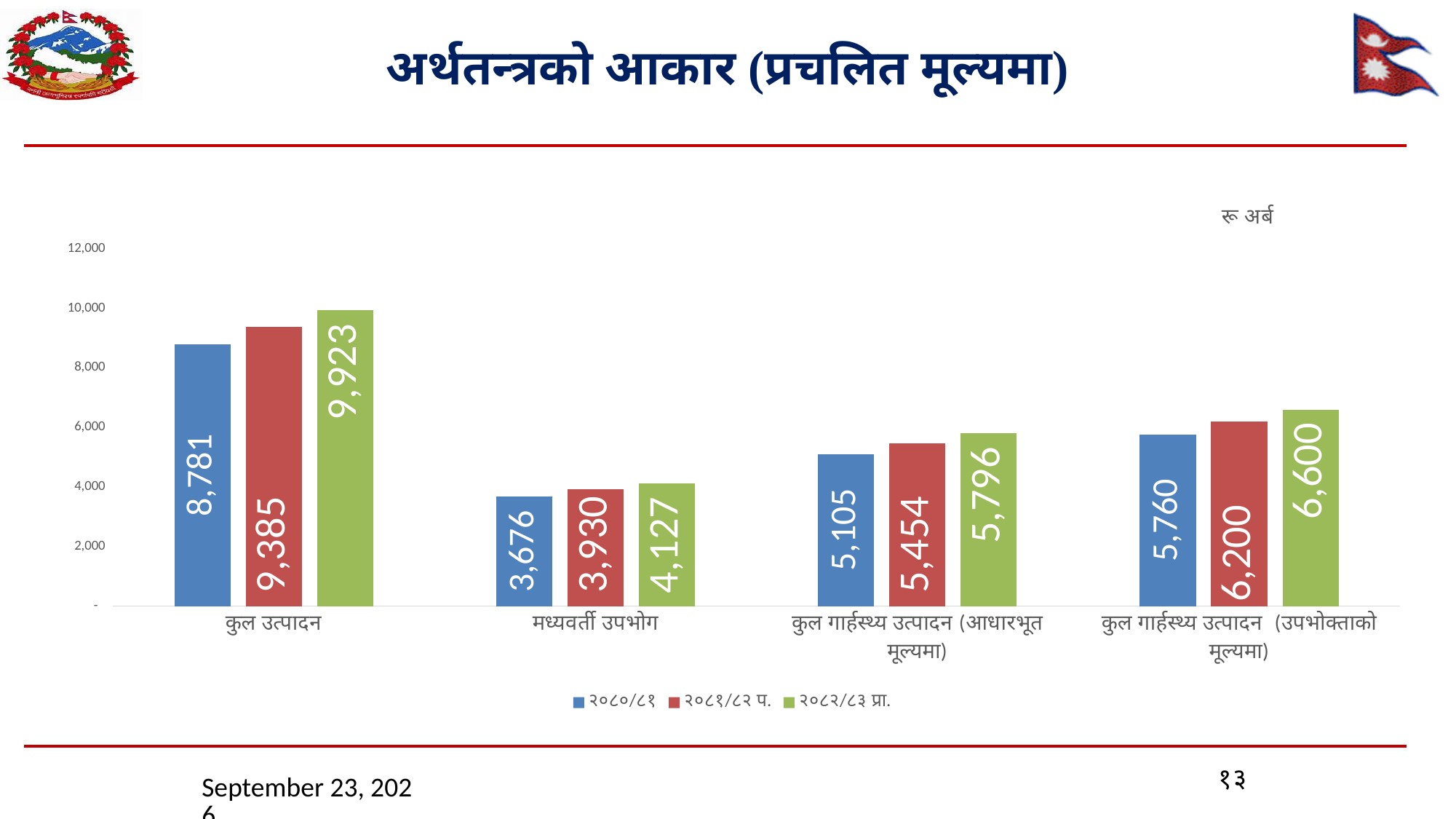
Which category has the highest value in the २०८१/८२ प. series? कुल उत्पादन What is the value for कुल उत्पादन in the २०८२/८३ प्रा. series? 9,923 Which category has the lowest value in the २०८२/८३ प्रा. series? मध्यवर्ती उपभोग What is the value for कुल गार्हस्थ्य उत्पादन (उपभोक्ताको मूल्यमा) in the २०८१/८२ प. series? 6,200 What is the value for मध्यवर्ती उपभोग in the २०८०/८१ series? 3,676 How many categories are shown on the x axis? 4 What unit is indicated in the top right corner of the chart? रू अर्ब What type of chart is shown on the slide? bar chart What is the difference between the २०८२/८३ प्रा. and २०८०/८१ values for कुल उत्पादन? 1,142 Which is larger: the २०८२/८३ प्रा. value for कुल गार्हस्थ्य उत्पादन (आधारभूत मूल्यमा) or the २०८०/८१ value for कुल गार्हस्थ्य उत्पादन (उपभोक्ताको मूल्यमा)? कुल गार्हस्थ्य उत्पादन (आधारभूत मूल्यमा) in २०८२/८३ प्रा. Across the three series, do the values for मध्यवर्ती उपभोग rise or fall from २०८०/८१ to २०८२/८३ प्रा.? rise How many series does the legend list? 3